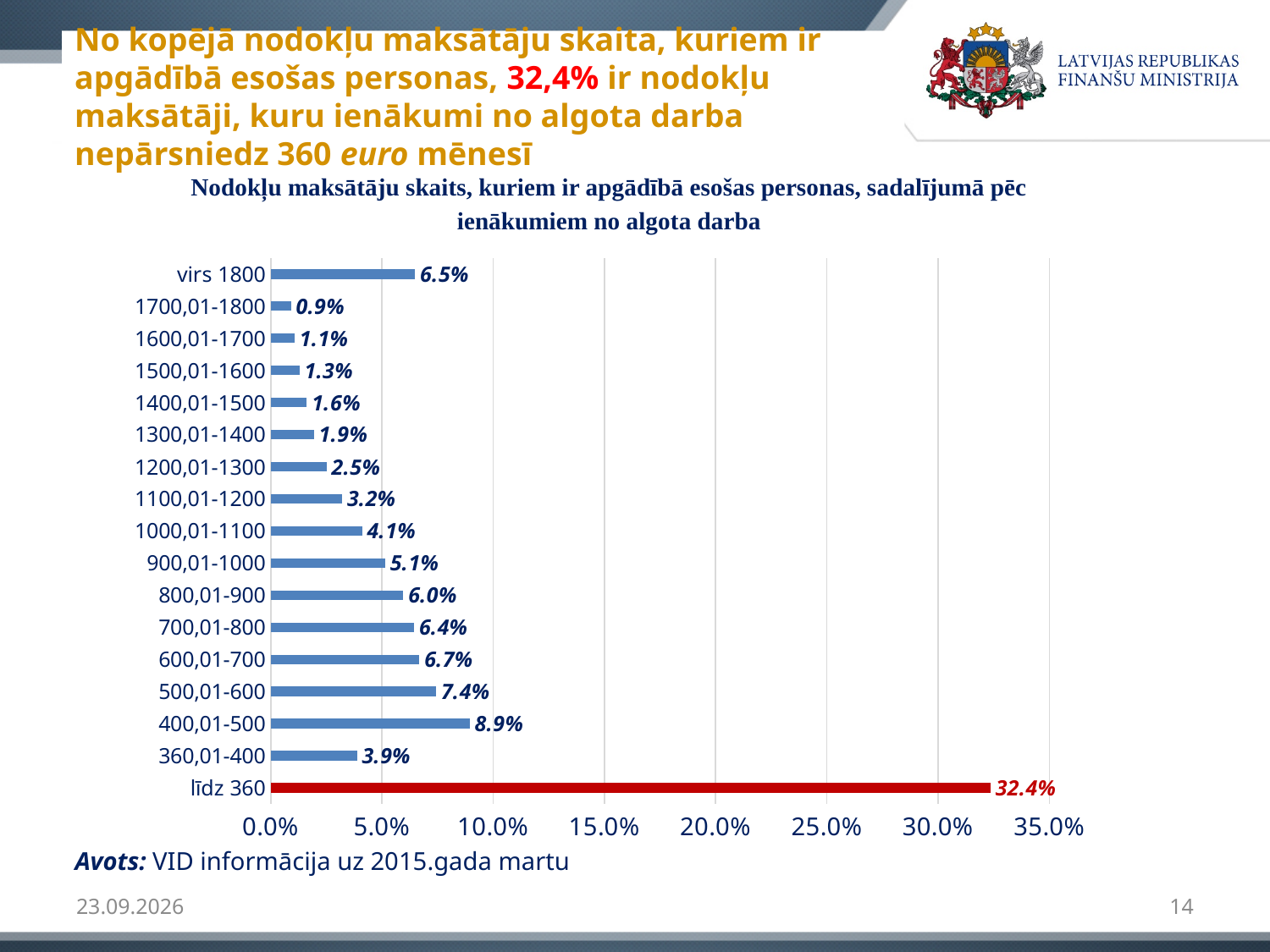
Is the value for "līdz 360" greater or less than 30.0%? greater How many categories are shown on the chart? 17 What kind of chart is shown on the slide? bar chart What is the value for the "virs 1800" category? 6.5% Which category has the highest value? līdz 360 What is the value for the "1000,01-1100" category? 4.1% What is the difference between the values for "līdz 360" and "400,01-500"? 23.5% What is the value for the "līdz 360" category? 32.4% Which bar is coloured red rather than blue? līdz 360 Which category has the lowest value? 1700,01-1800 What is the value for the "400,01-500" category? 8.9% Which is larger, the value for "500,01-600" or the value for "360,01-400"? 500,01-600